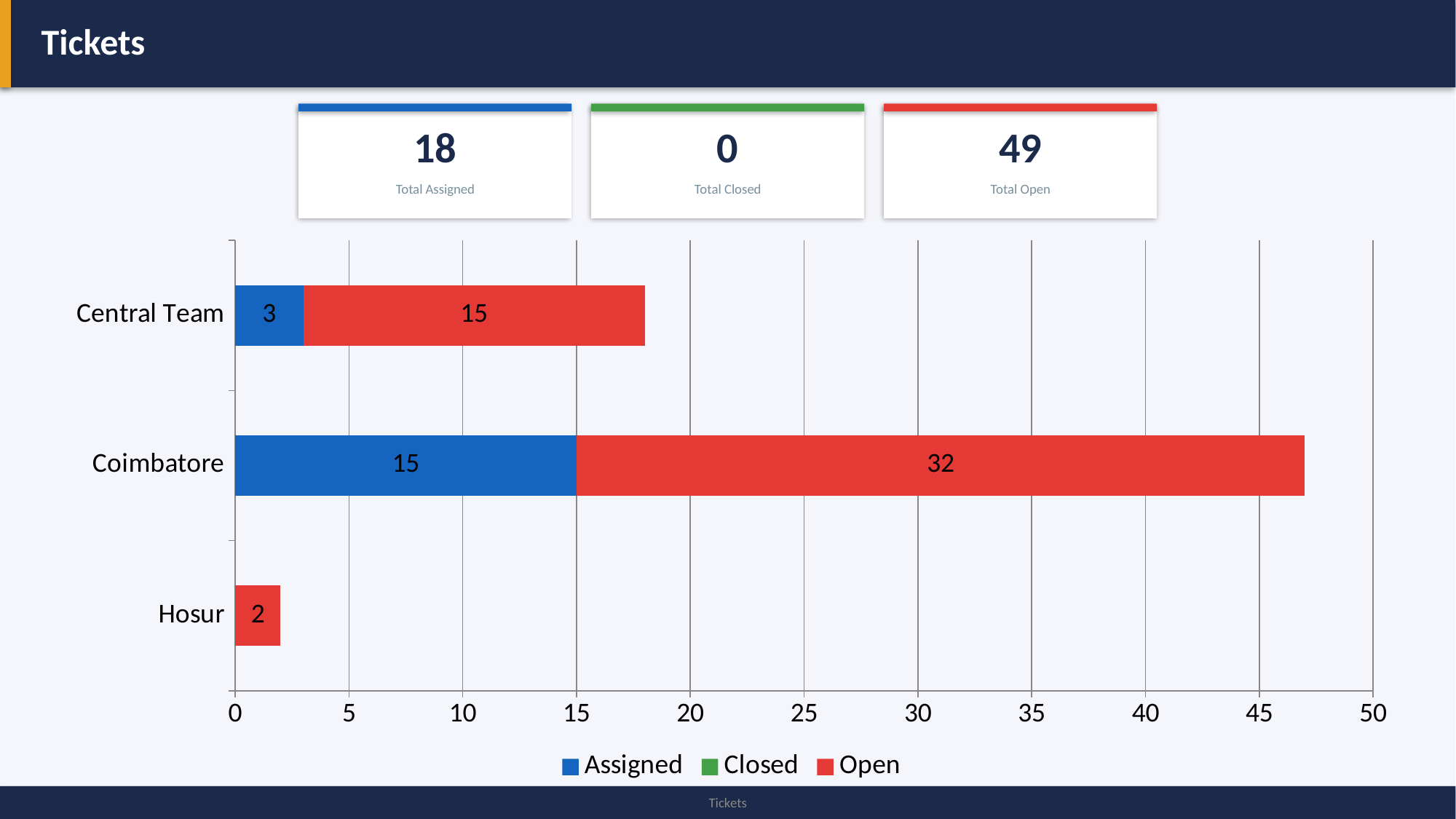
What is the difference between the Open values for Coimbatore and Central Team? 17 How many series does the legend list? 3 Which category has the highest Open value? Coimbatore What kind of chart is shown on the slide? Stacked bar chart How many categories are shown on the chart? 3 What is the total of the stacked bar for Coimbatore? 47 What is the Open value for Coimbatore? 32 Which is larger, the Open value for Central Team or the Assigned value for Central Team? Open value for Central Team What is the Assigned value for Central Team? 3 What is the Open value for Hosur? 2 Which category has the lowest Open value? Hosur What is the Assigned value for Coimbatore? 15